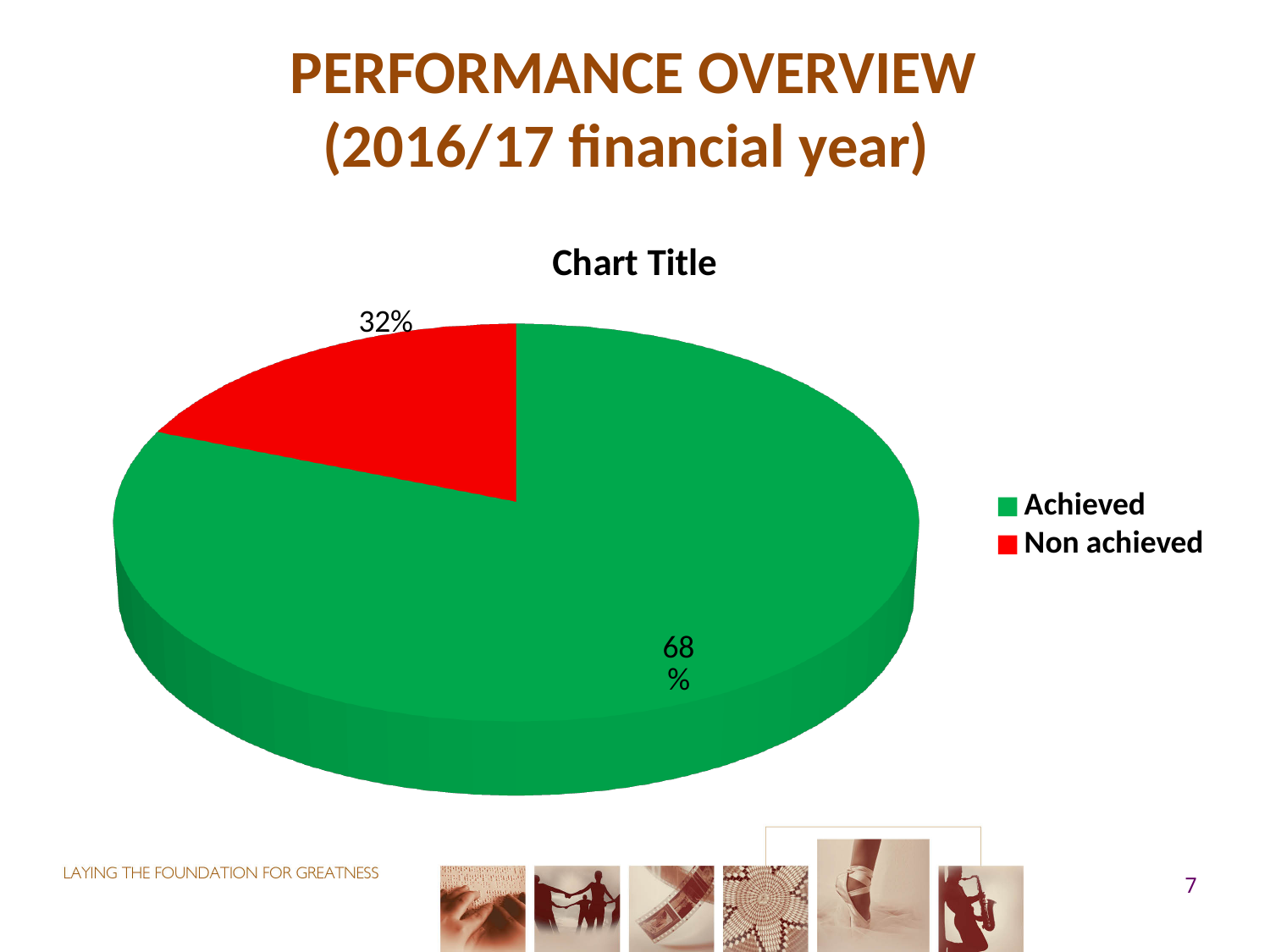
How many entries does the legend list? 2 What is the title shown above the pie chart? Chart Title What kind of chart is shown on the slide? Pie chart How many slices does the pie chart have? 2 What percentage of the pie is labelled Non achieved? 32% What percentage of the pie is labelled Achieved? 68% What colour is the Achieved slice? Green Which slice of the pie is the smallest? Non achieved Which is larger, the Achieved slice or the Non achieved slice? Achieved Which slice of the pie is the largest? Achieved What share of the pie does the Non achieved slice represent? 32% What is the difference in percentage points between the Achieved and Non achieved slices? 36